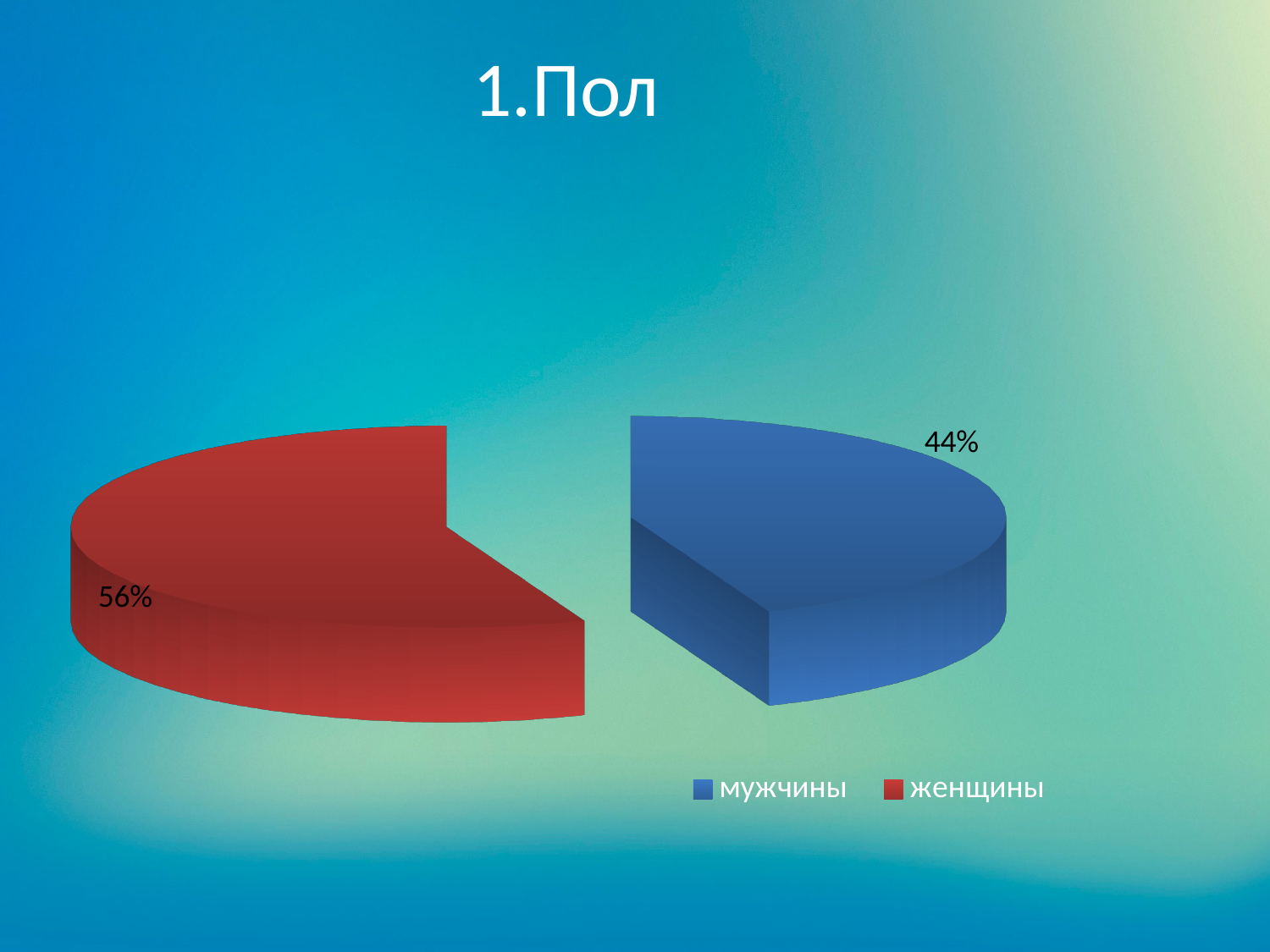
Which category has the largest share? женщины What is the difference between the shares of женщины and мужчины? 12% Which is larger, the share of мужчины or the share of женщины? женщины How many entries does the legend list? 2 How many slices does the pie chart have? 2 What is the title of the slide? 1.Пол What is the value for мужчины? 44% What kind of chart is shown on the slide? pie chart What is the total of the two slices? 100% Which category has the smallest share? мужчины What colour is the slice for мужчины? blue What is the value for женщины? 56%